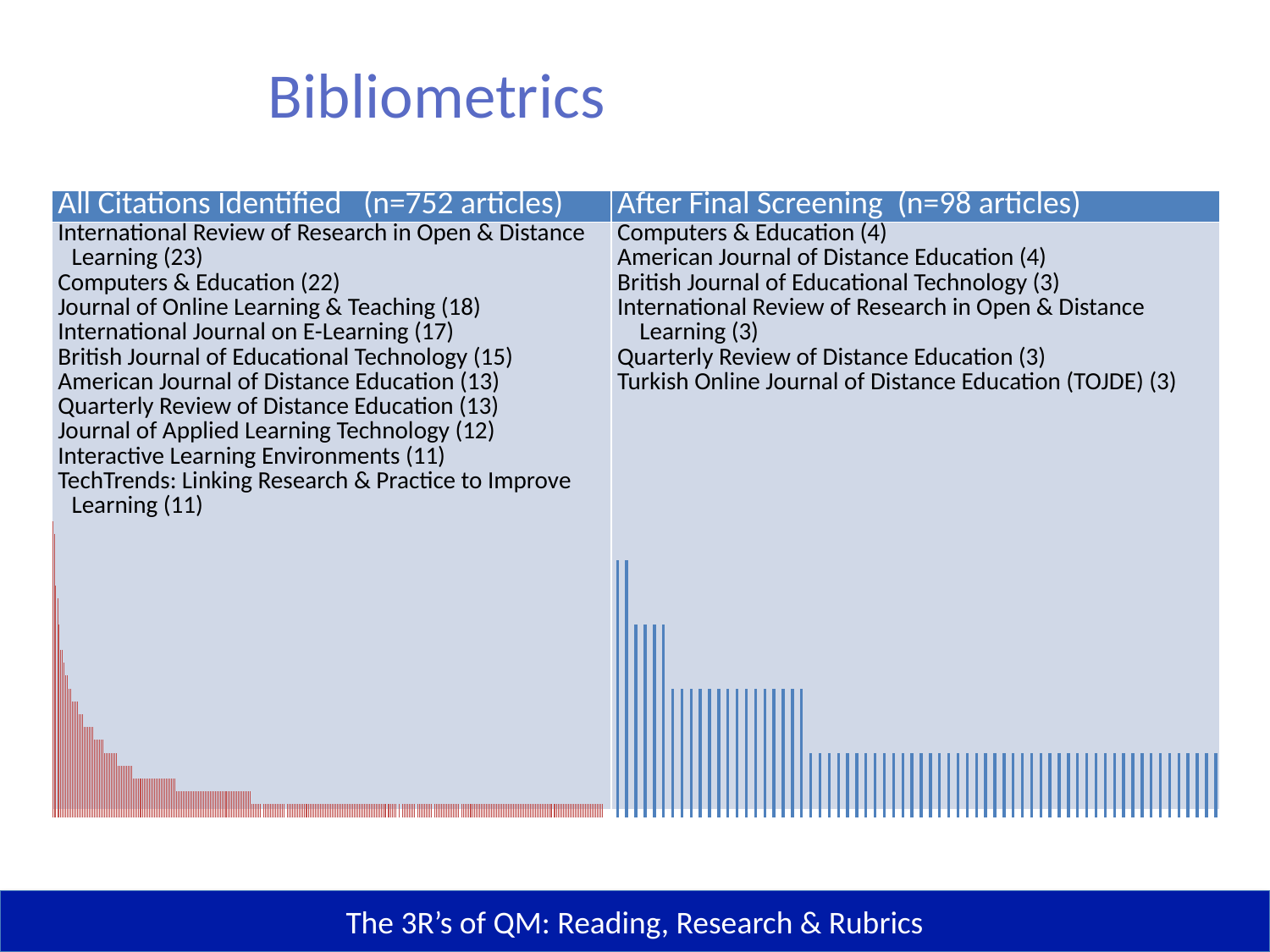
In the 'All Citations Identified' list, how many articles are attributed to Computers & Education? 22 What is the difference between the counts for Computers & Education and American Journal of Distance Education in the 'All Citations Identified' list? 9 In the 'After Final Screening' list, how many articles are attributed to British Journal of Educational Technology? 3 In the 'All Citations Identified' list, how many articles are attributed to International Review of Research in Open & Distance Learning? 23 In the 'All Citations Identified' list, which has more articles: Journal of Online Learning & Teaching or British Journal of Educational Technology? Journal of Online Learning & Teaching In the 'After Final Screening' list, how many articles are attributed to Computers & Education? 4 How many articles in total does the 'After Final Screening' column header report? 98 In the 'All Citations Identified' chart, do the bar heights rise or fall from left to right? fall What kind of chart is shown under the 'All Citations Identified' column? bar chart In the 'After Final Screening' chart, do the bar heights rise or fall from left to right? fall Which journal has the highest count in the 'All Citations Identified' list? International Review of Research in Open & Distance Learning What kind of chart is shown under the 'After Final Screening' column? bar chart